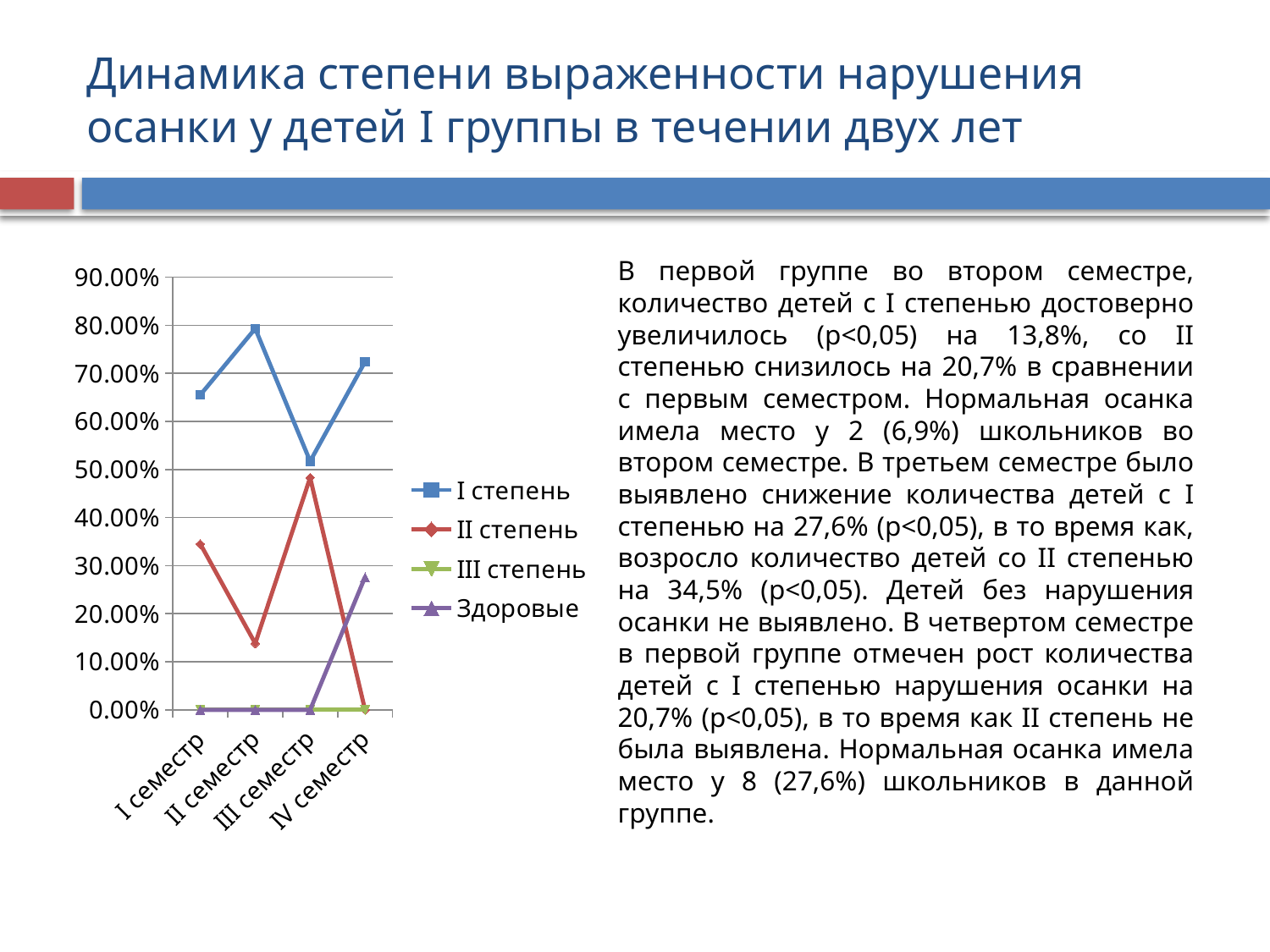
Is the value for II степень in II семестр greater or less than 20.00%? less Which is larger in I семестр: the value for I степень or the value for II степень? I степень What is the value for III степень in I семестр? 0.00% How many categories are shown on the x axis of the chart? 4 Does the II степень series rise or fall from III семестр to IV семестр? fall In which semester does the I степень series reach its highest value? II семестр In which semester does the I степень series reach its lowest value? III семестр Is the value for Здоровые in IV семестр greater or less than 20.00%? greater In which semester does the II степень series reach its highest value? III семестр Is the value for I степень in II семестр greater or less than 70.00%? greater How many series does the chart legend list? 4 What kind of chart is shown on the slide? line chart